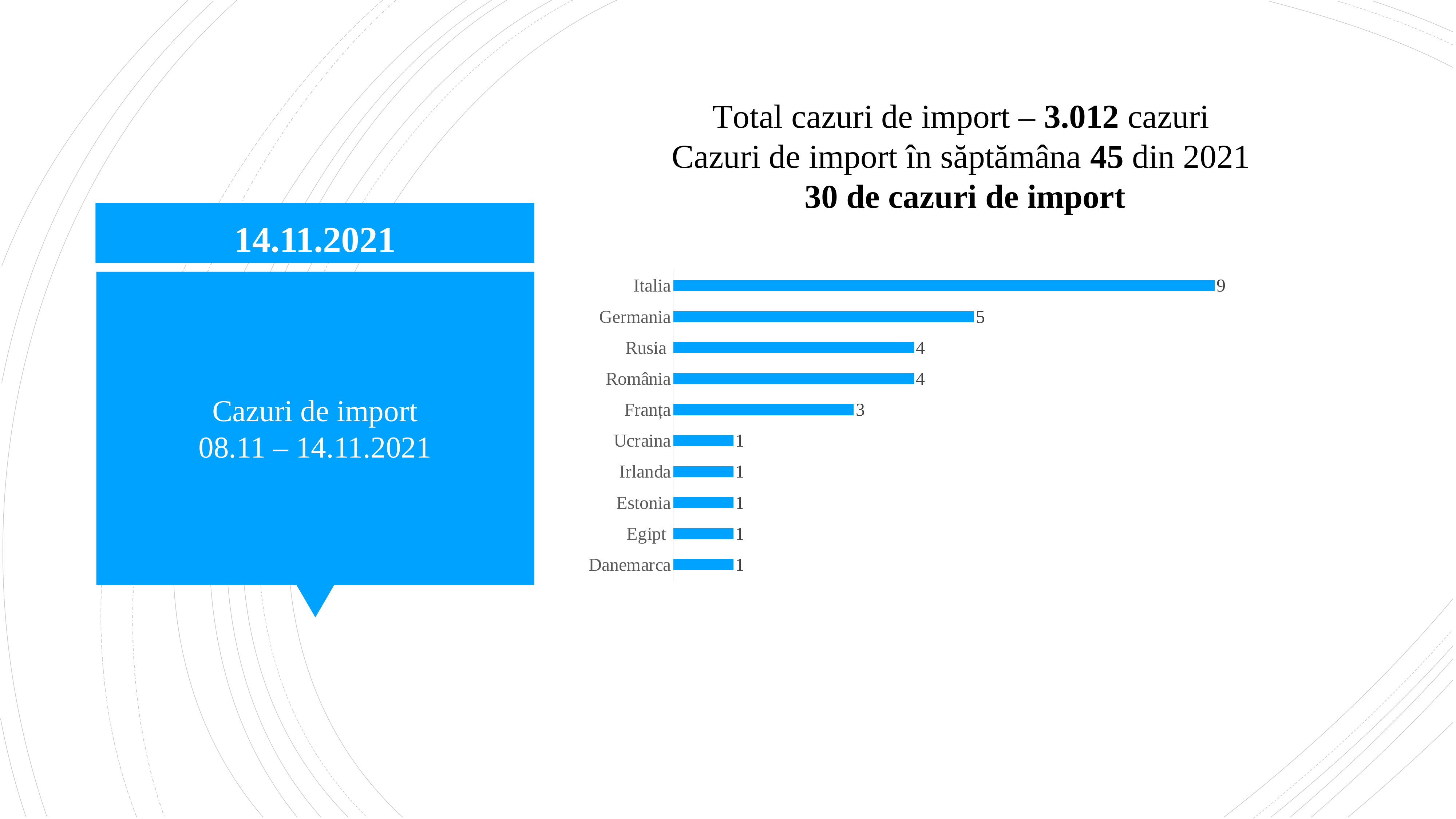
What is the difference between the values for Italia and Germania? 4 How many countries have a value of 1? 5 How many countries are shown in the chart? 10 Which country has the highest value? Italia What is the difference between the values for Germania and Franța? 2 What kind of chart is shown on the slide? bar chart What is the value for Germania? 5 What colour are the bars in the chart? blue Which is larger, the value for Rusia or the value for Ucraina? Rusia What is the value for Italia? 9 What is the value for Rusia? 4 What is the value for Franța? 3